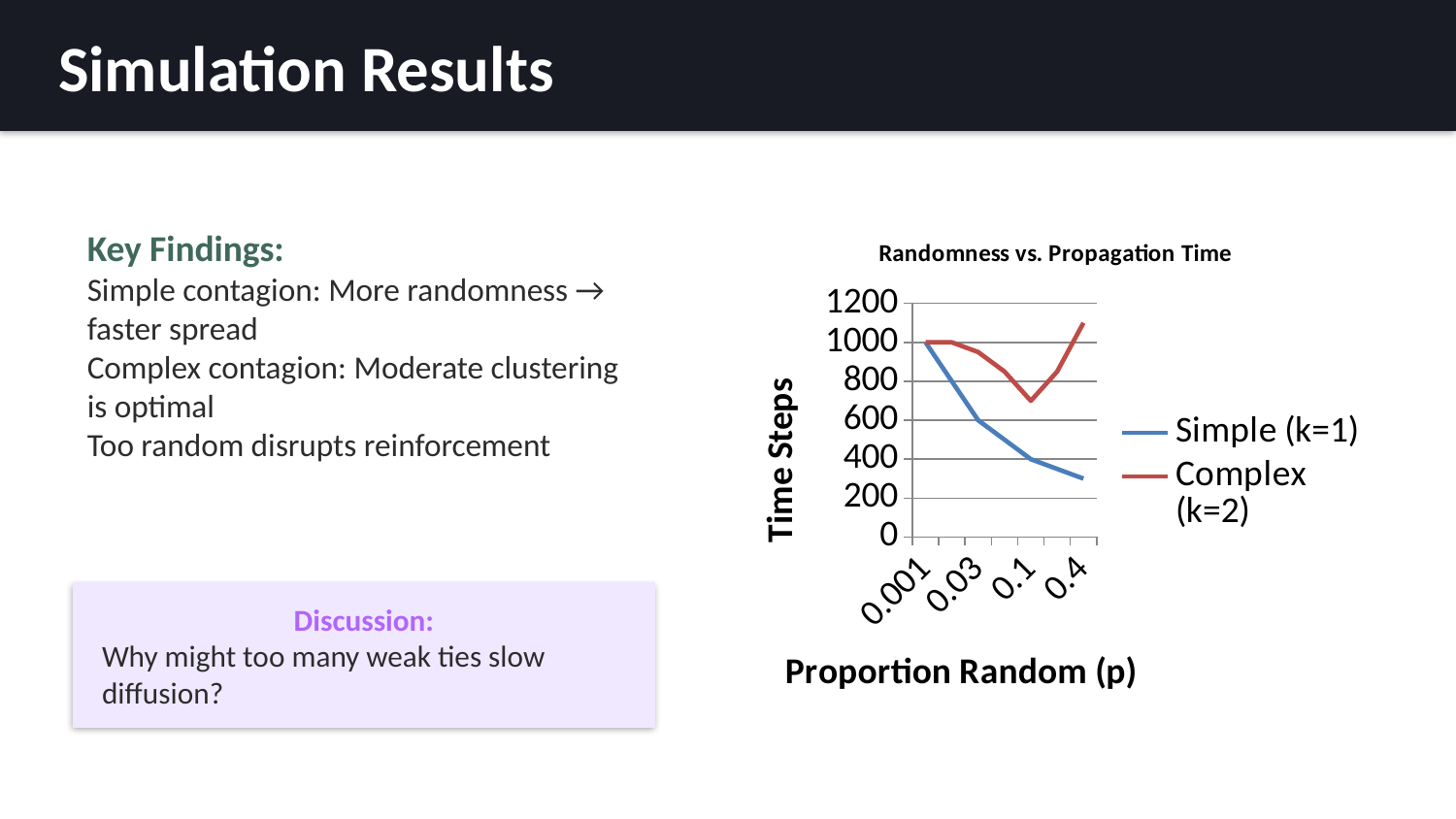
At p = 0.4, which series has the higher Time Steps value, Simple (k=1) or Complex (k=2)? Complex (k=2) At which value of p does the Complex (k=2) series reach its lowest Time Steps? 0.1 What is the label of the y axis? Time Steps What kind of chart is shown on the slide? line chart Is the Complex (k=2) value at p = 0.4 greater or less than 1000? greater How many series does the chart's legend list? 2 What is the title of the chart? Randomness vs. Propagation Time Is the Simple (k=1) value at p = 0.4 greater or less than 400? less Does the Simple (k=1) series rise or fall as Proportion Random (p) increases? fall Is the Complex (k=2) value at p = 0.1 greater or less than 800? less At which value of p does the Complex (k=2) series reach its highest Time Steps? 0.4